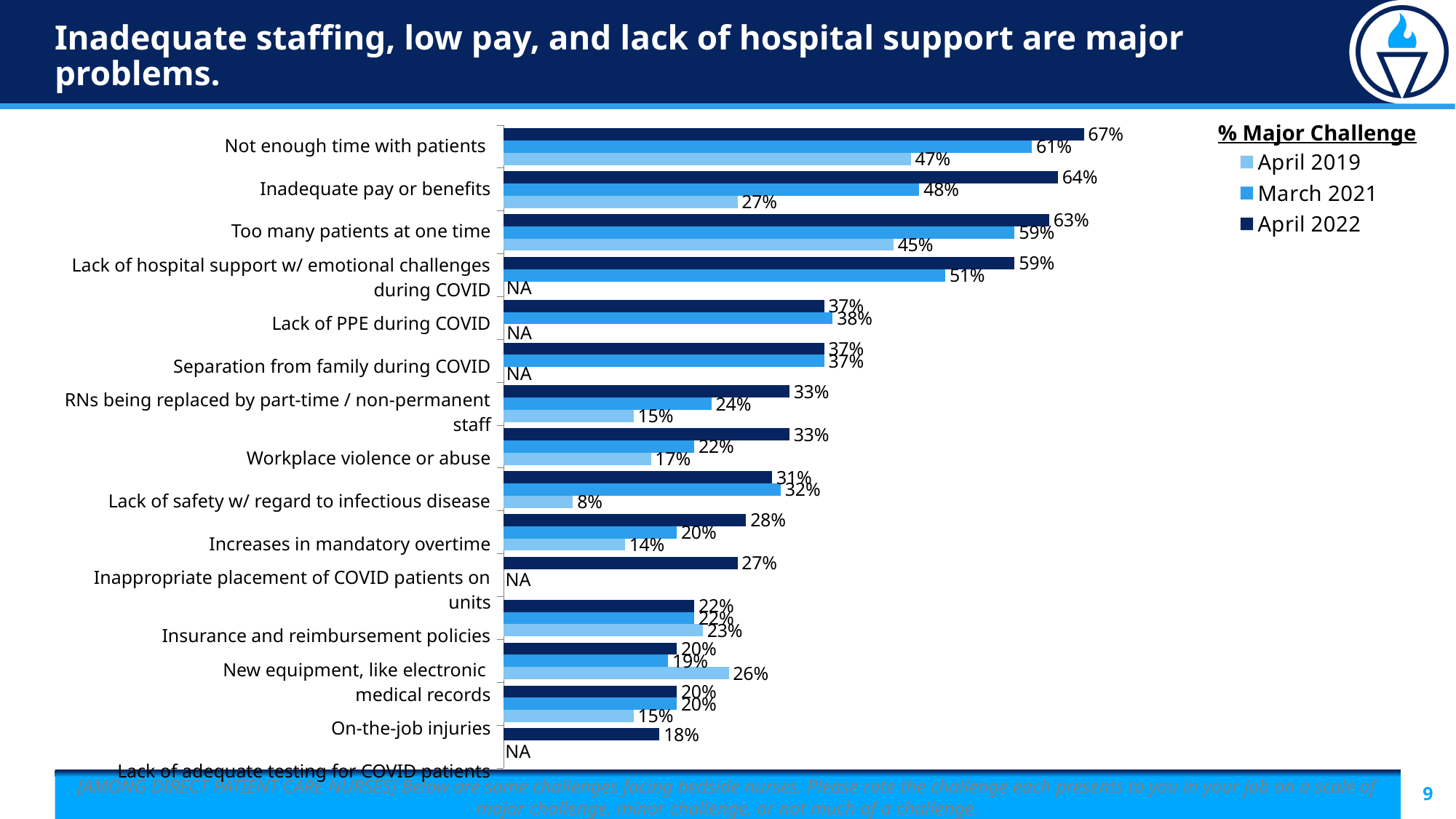
What is the April 2022 value for "Inadequate pay or benefits"? 64% Do the values for "Inadequate pay or benefits" rise or fall from April 2019 to April 2022? Rise What is the April 2019 value for "Not enough time with patients"? 47% Which category has the highest April 2022 value? Not enough time with patients What kind of chart is shown on the slide? Bar chart What is the March 2021 value for "Lack of PPE during COVID"? 38% Which category has the lowest April 2019 value? Lack of safety w/ regard to infectious disease What is the heading shown above the legend? % Major Challenge How many series does the legend list? 3 What is shown for April 2019 for "Lack of hospital support w/ emotional challenges during COVID"? NA What is the difference between the April 2022 and April 2019 values for "Inadequate pay or benefits"? 37 percentage points Which is larger for April 2019: "Increases in mandatory overtime" or "Lack of safety w/ regard to infectious disease"? Increases in mandatory overtime